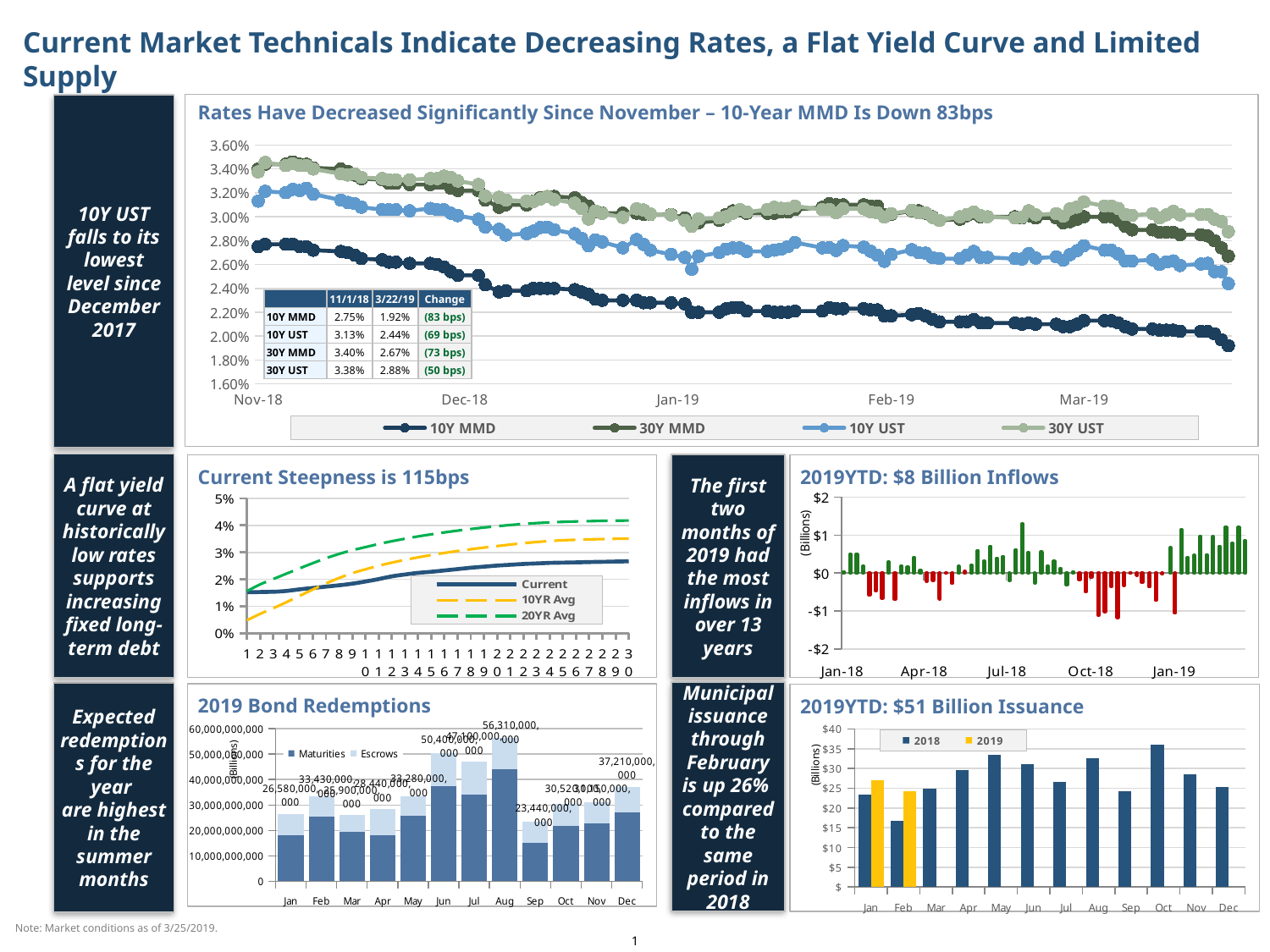
How many series does the legend of the 'Rates Have Decreased Significantly Since November' chart list? 4 In the '2019YTD: $51 Billion Issuance' chart, which month has the highest 2018 bar? Oct In the '2019 Bond Redemptions' chart, what is the total redemption value labelled for Aug? 56,310,000,000 In the 'Current Steepness is 115bps' chart, does the Current line rise or fall along the x axis? rise In the '2019 Bond Redemptions' chart, which month has the lowest total redemptions? Sep In the '2019YTD: $51 Billion Issuance' chart, is the 2018 value for Feb greater or less than $20? less In the '2019 Bond Redemptions' chart, which month has the highest total redemptions? Aug How many series does the legend of the 'Current Steepness is 115bps' chart list? 3 In the 'Rates Have Decreased Significantly Since November' chart, what change does the inset table show for 30Y UST? (50 bps) What kind of chart is the '2019YTD: $8 Billion Inflows' chart? bar chart In the 'Rates Have Decreased Significantly Since November' chart, what is the 3/22/19 value for 10Y MMD shown in the inset table? 1.92% What kind of chart is the 'Rates Have Decreased Significantly Since November' chart? line chart